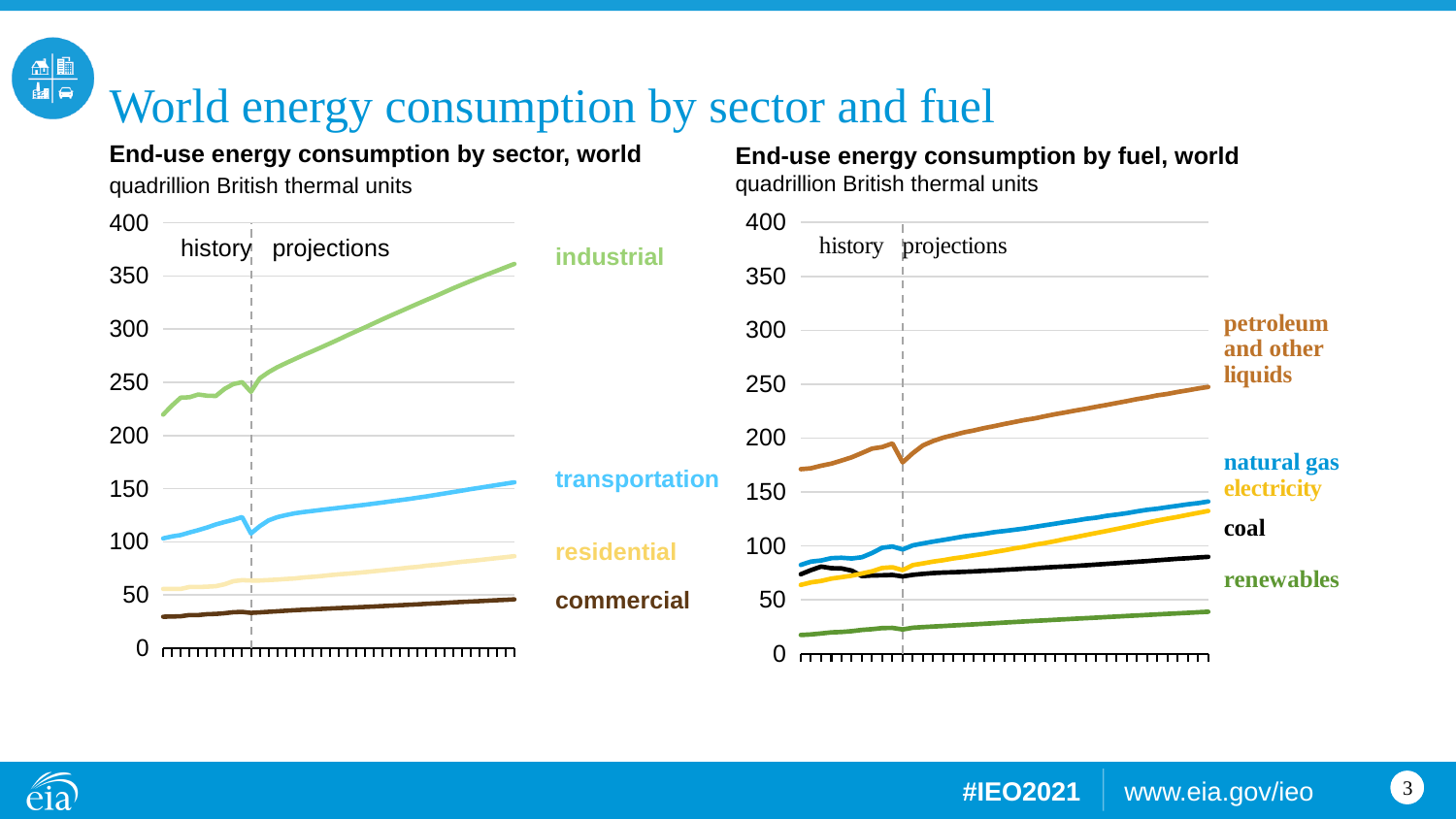
How many series are plotted on the 'End-use energy consumption by fuel, world' chart? 5 On the 'End-use energy consumption by sector, world' chart, which sector has the highest consumption at the end of the projection period? industrial On the 'End-use energy consumption by fuel, world' chart, which fuel has the lowest consumption? renewables On the 'End-use energy consumption by fuel, world' chart, which is larger at the end of the projections, natural gas or coal? natural gas On the 'End-use energy consumption by fuel, world' chart, which fuel has the highest consumption? petroleum and other liquids On the 'End-use energy consumption by sector, world' chart, is the industrial value at the end of the projections greater or less than 300? greater On the 'End-use energy consumption by sector, world' chart, which sector has the lowest consumption throughout? commercial What kind of chart is the 'End-use energy consumption by sector, world' chart? line chart On the 'End-use energy consumption by fuel, world' chart, is the coal value at the end of the projections greater or less than 100? less On the 'End-use energy consumption by sector, world' chart, does industrial consumption rise or fall over the projection period? rise On the 'End-use energy consumption by sector, world' chart, is the commercial value at the end of the projections greater or less than 50? less How many series are plotted on the 'End-use energy consumption by sector, world' chart? 4